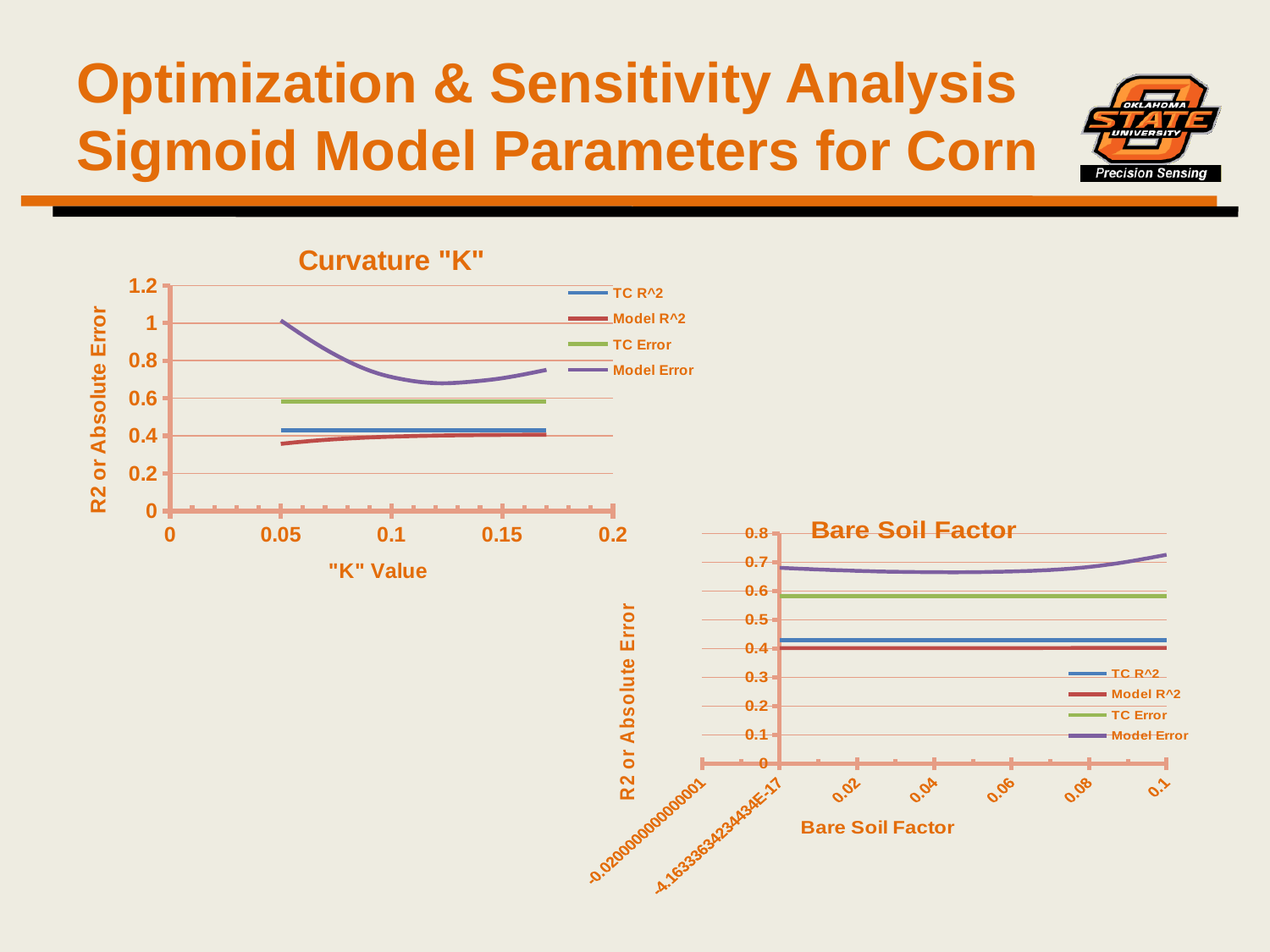
In the "Bare Soil Factor" chart, is the Model Error value at a Bare Soil Factor of 0.1 greater or less than 0.6? greater In the "Curvature "K"" chart, which series is higher, TC Error or TC R^2? TC Error In the "Curvature "K"" chart, does the Model R^2 line rise or fall as the "K" Value increases? rises What kind of chart is the "Curvature "K"" chart? line chart In the "Curvature "K"" chart, is the Model Error value at a "K" Value of 0.05 greater or less than 0.8? greater In the "Curvature "K"" chart, which series has the highest values across the plotted range? Model Error What is the x-axis title of the "Curvature "K"" chart? "K" Value How many series does the legend of the "Curvature "K"" chart list? 4 In the "Bare Soil Factor" chart, which series is higher, Model Error or TC Error? Model Error In the "Bare Soil Factor" chart, is the TC R^2 value greater or less than 0.5? less In the "Curvature "K"" chart, which series has the lowest values across the plotted range? Model R^2 What kind of chart is the "Bare Soil Factor" chart? line chart